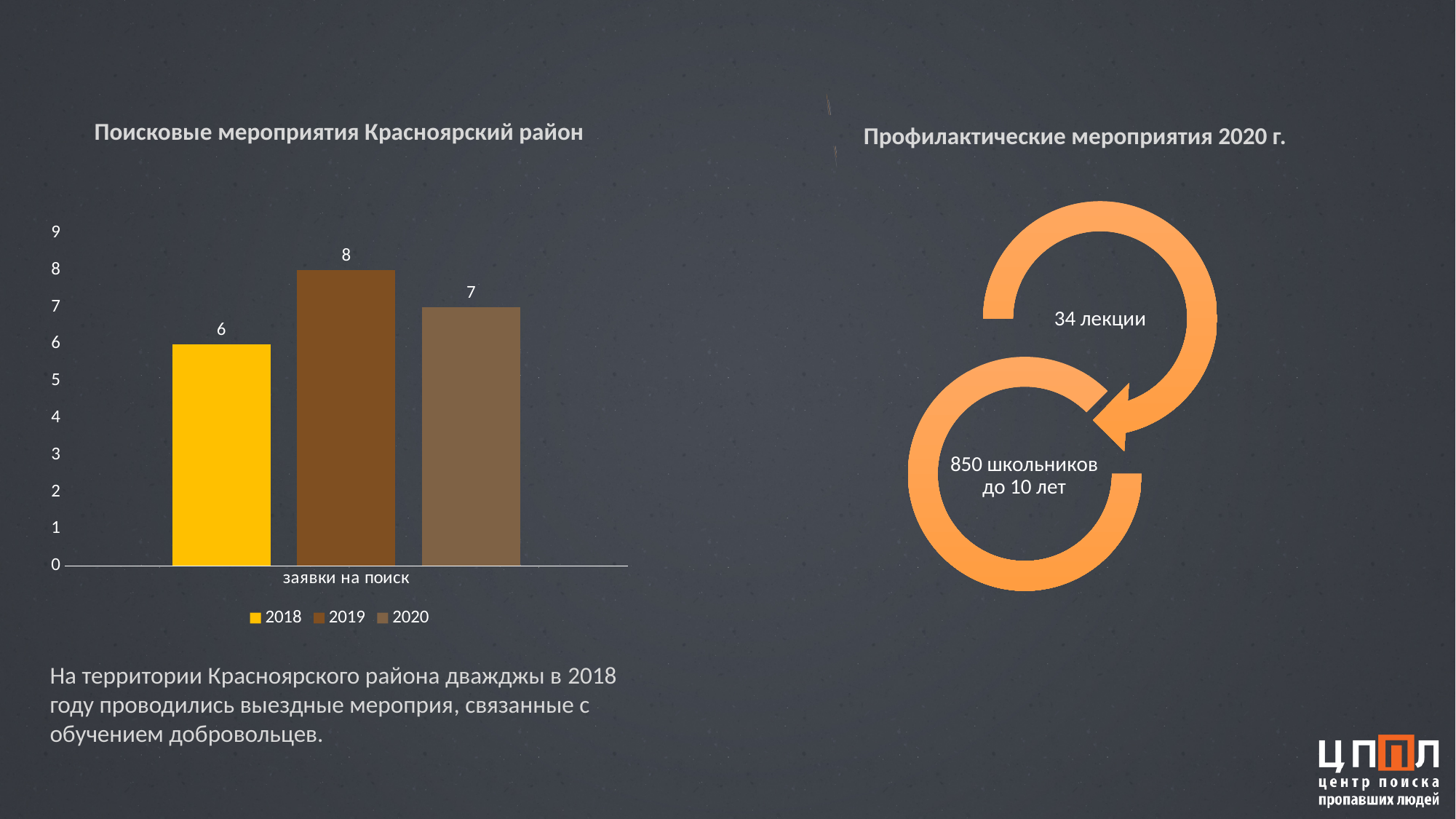
Which year has the highest value in the chart "Поисковые мероприятия Красноярский район"? 2019 How many series does the legend of the chart "Поисковые мероприятия Красноярский район" list? 3 Which is larger in the chart "Поисковые мероприятия Красноярский район": the value for 2020 or the value for 2018? 2020 What kind of chart is "Поисковые мероприятия Красноярский район"? bar chart What is the category label on the x axis of the chart "Поисковые мероприятия Красноярский район"? заявки на поиск Which series is shown in yellow in the chart "Поисковые мероприятия Красноярский район"? 2018 Is the value for 2019 in the chart "Поисковые мероприятия Красноярский район" greater or less than 5? greater What is the value for 2018 in the chart "Поисковые мероприятия Красноярский район"? 6 What is the difference between the values for 2019 and 2018 in the chart "Поисковые мероприятия Красноярский район"? 2 Which year has the lowest value in the chart "Поисковые мероприятия Красноярский район"? 2018 What is the value for 2020 in the chart "Поисковые мероприятия Красноярский район"? 7 What is the value for 2019 in the chart "Поисковые мероприятия Красноярский район"? 8